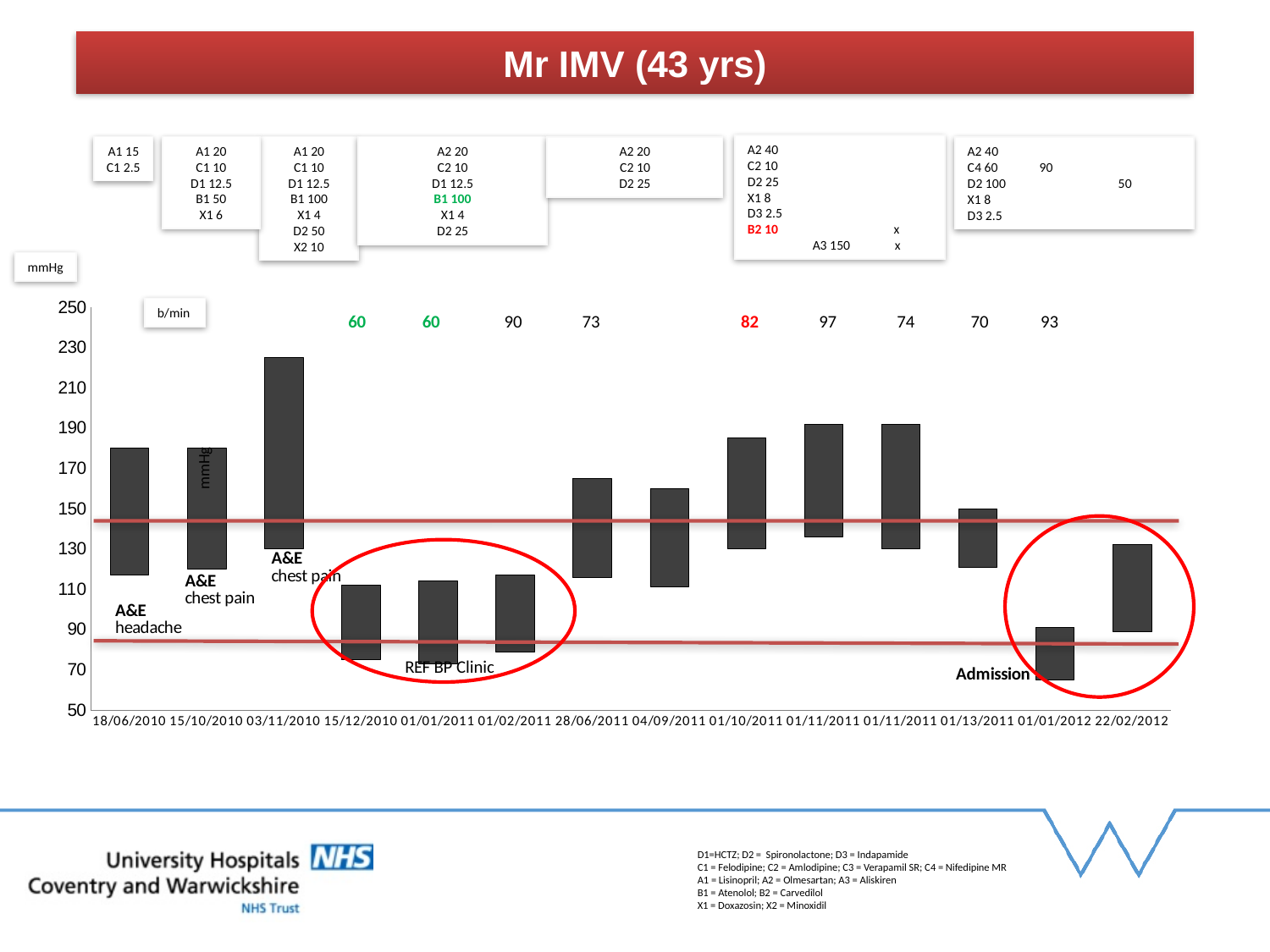
Is the bottom of the bar for 15/12/2010 greater or less than 90? less On which date does the bar reach the highest value on the chart? 03/11/2010 Which bar reaches a higher top value: 03/11/2010 or 18/06/2010? 03/11/2010 Is the top of the bar for 01/10/2011 greater or less than 170? greater What heart rate (b/min) is printed above the bar for 01/10/2011? 82 Is the top of the bar for 03/11/2010 greater or less than 210? greater What unit is shown on the y axis of the chart? mmHg Does the top of the bars rise or fall from 03/11/2010 to 15/12/2010? fall What kind of chart is shown on the slide? bar chart What heart rate (b/min) is printed above the bar for 01/01/2012? 93 How many bars (dates) are plotted on the chart? 14 On which date does the bar reach the lowest value on the chart? 01/01/2012